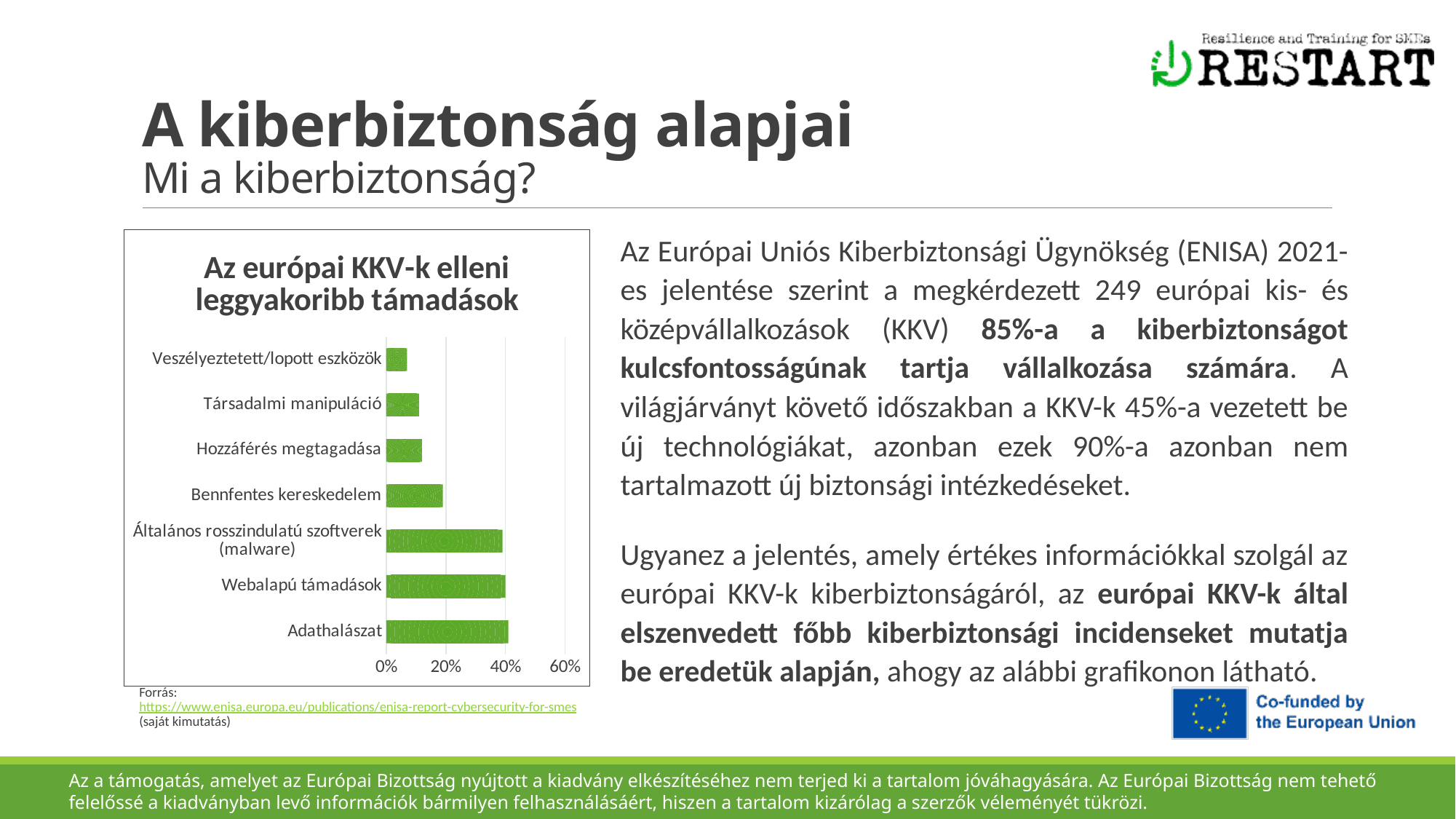
Which category has the lowest value in the chart? Veszélyeztetett/lopott eszközök Is the value for Webalapú támadások greater or less than 20%? greater What is the title of the chart on the slide? Az európai KKV-k elleni leggyakoribb támadások Which is larger, the value for Webalapú támadások or the value for Társadalmi manipuláció? Webalapú támadások Which is larger, the value for Bennfentes kereskedelem or the value for Hozzáférés megtagadása? Bennfentes kereskedelem Is the value for Társadalmi manipuláció greater or less than 20%? less What kind of chart is shown on the slide? bar chart How many categories does the chart show? 7 Is the value for Adathalászat greater or less than 20%? greater What colour are the bars in the chart? green Which is larger, the value for Általános rosszindulatú szoftverek (malware) or the value for Veszélyeztetett/lopott eszközök? Általános rosszindulatú szoftverek (malware)